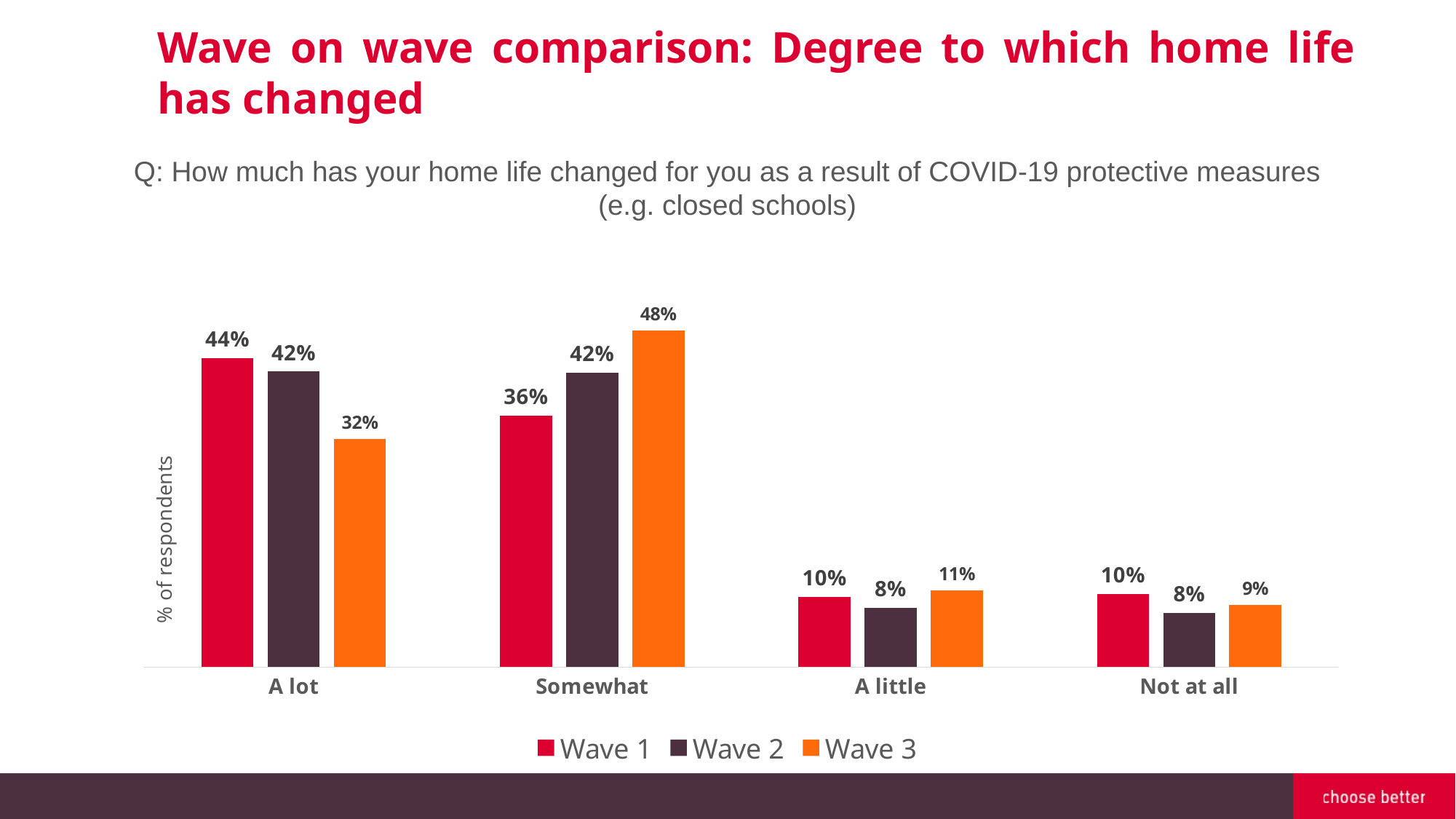
Which is larger for "Somewhat": the Wave 1 value or the Wave 3 value? Wave 3 Which category has the highest Wave 3 value? Somewhat What is the Wave 2 value for "Not at all"? 8% What is the label on the vertical axis? % of respondents What is the Wave 1 value for "A lot"? 44% How many series does the legend list? 3 How many categories are shown on the x axis? 4 What is the Wave 3 value for "Somewhat"? 48% Do the Wave 2 values rise or fall from "Somewhat" to "Not at all"? Fall What is the difference between the Wave 1 and Wave 3 values for "A lot"? 12% What kind of chart is shown on the slide? Bar chart